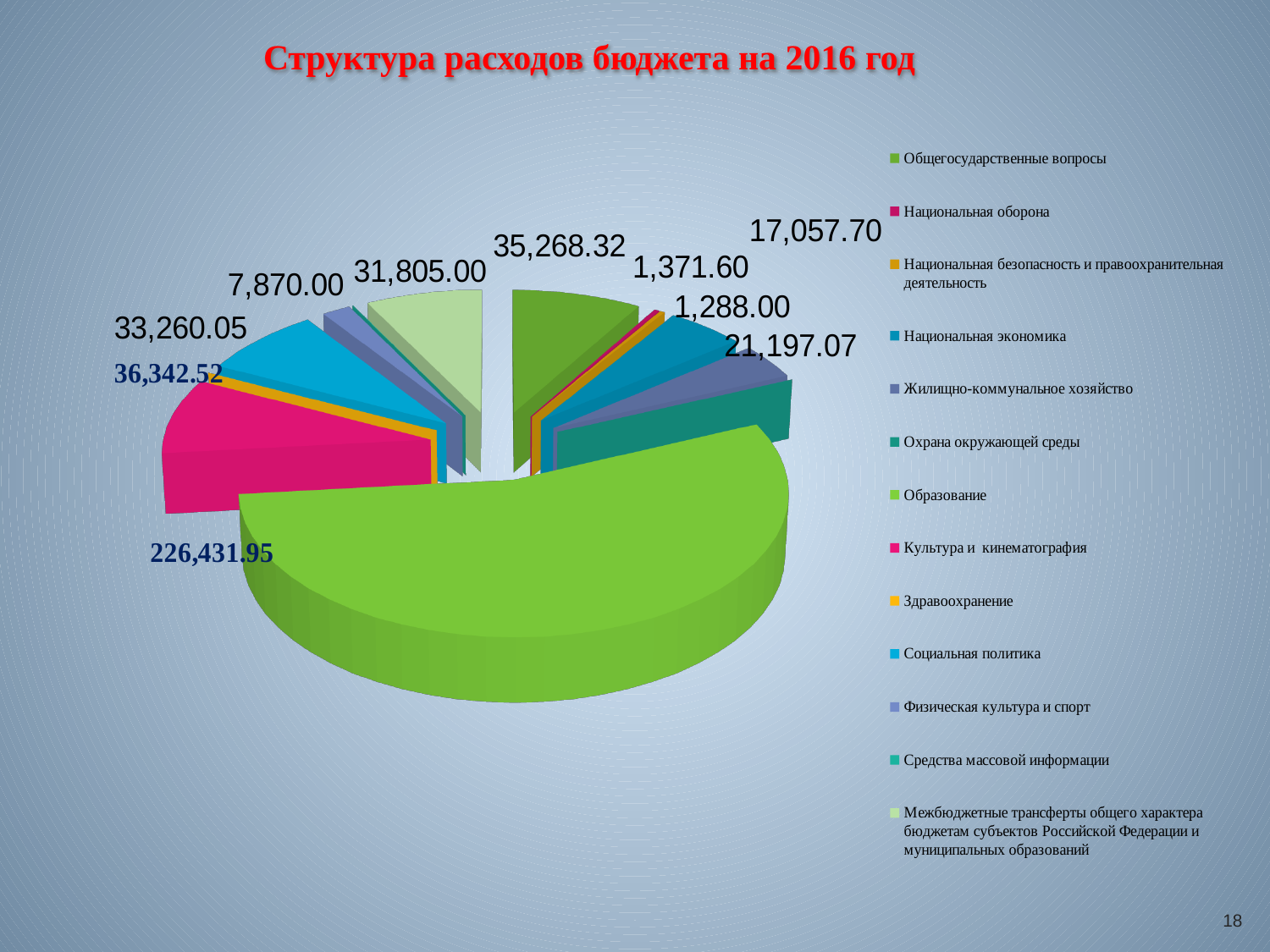
What is the difference between the values for Образование and Общегосударственные вопросы? 191,163.63 What is the title of the chart? Структура расходов бюджета на 2016 год Which category has the largest slice of the pie? Образование What is the value shown for Общегосударственные вопросы? 35,268.32 Which is larger, the value for Образование or the value for Культура и кинематография? Образование How many categories does the legend list? 13 What is the value shown for Социальная политика? 33,260.05 What is the value shown for Культура и кинематография? 36,342.52 What is the difference between the values for Культура и кинематография and Социальная политика? 3,082.47 What is the value shown for Физическая культура и спорт? 7,870.00 What kind of chart is shown on the slide? pie chart What is the value shown for Образование? 226,431.95